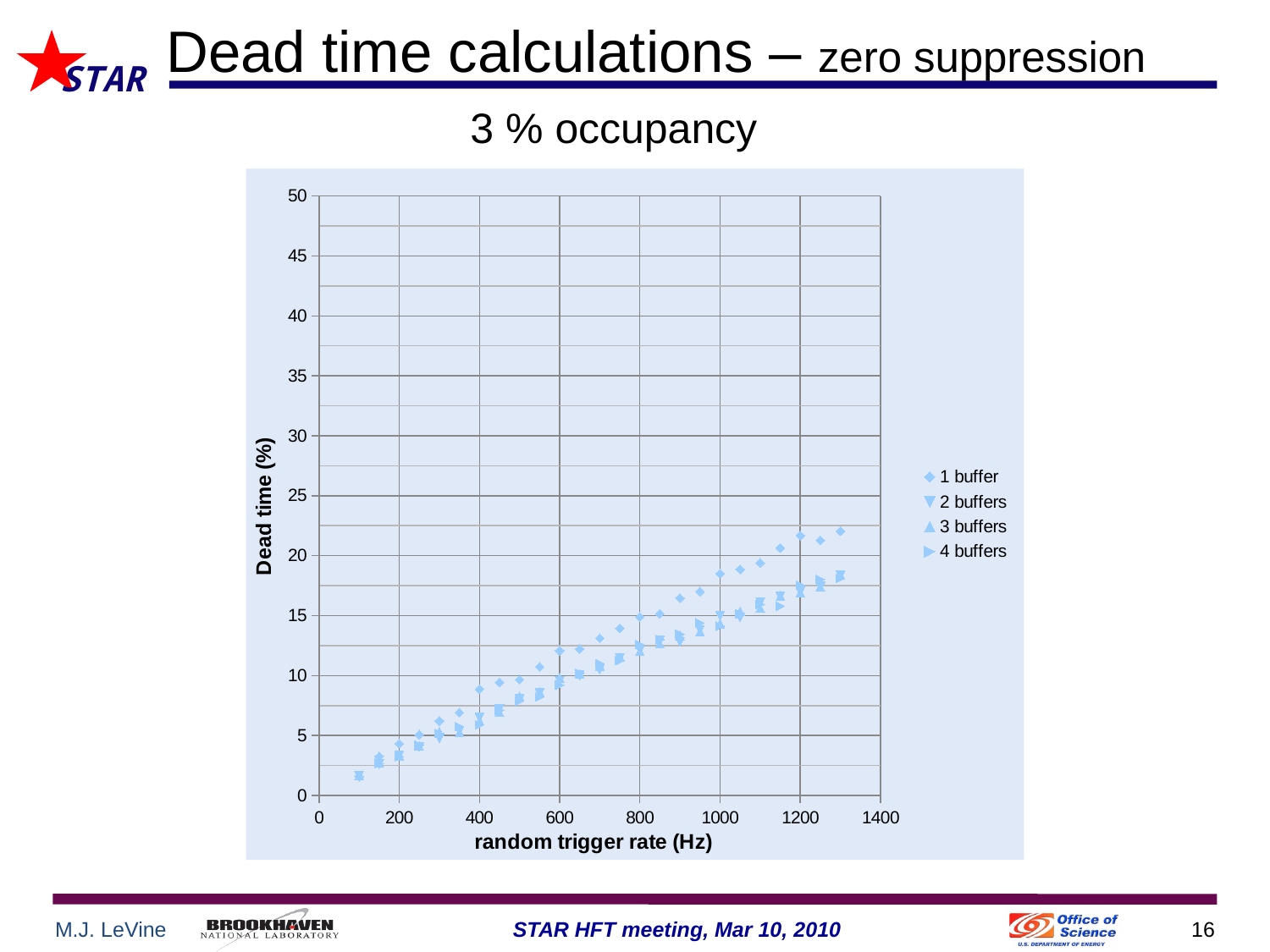
What kind of chart is shown on the slide? scatter chart What are the series names listed in the legend? 1 buffer, 2 buffers, 3 buffers, 4 buffers Is the dead time for 1 buffer at 600 Hz greater or less than 10? greater Is the dead time for 1 buffer at 1300 Hz greater or less than 20? greater Does the dead time rise or fall as the random trigger rate increases? rises At 1300 Hz, which series has the higher dead time, 1 buffer or 2 buffers? 1 buffer Is the dead time for 1 buffer at 1000 Hz greater or less than 15? greater What is the label of the x axis? random trigger rate (Hz) How many series does the legend list? 4 Which series has the highest dead time at 1200 Hz? 1 buffer